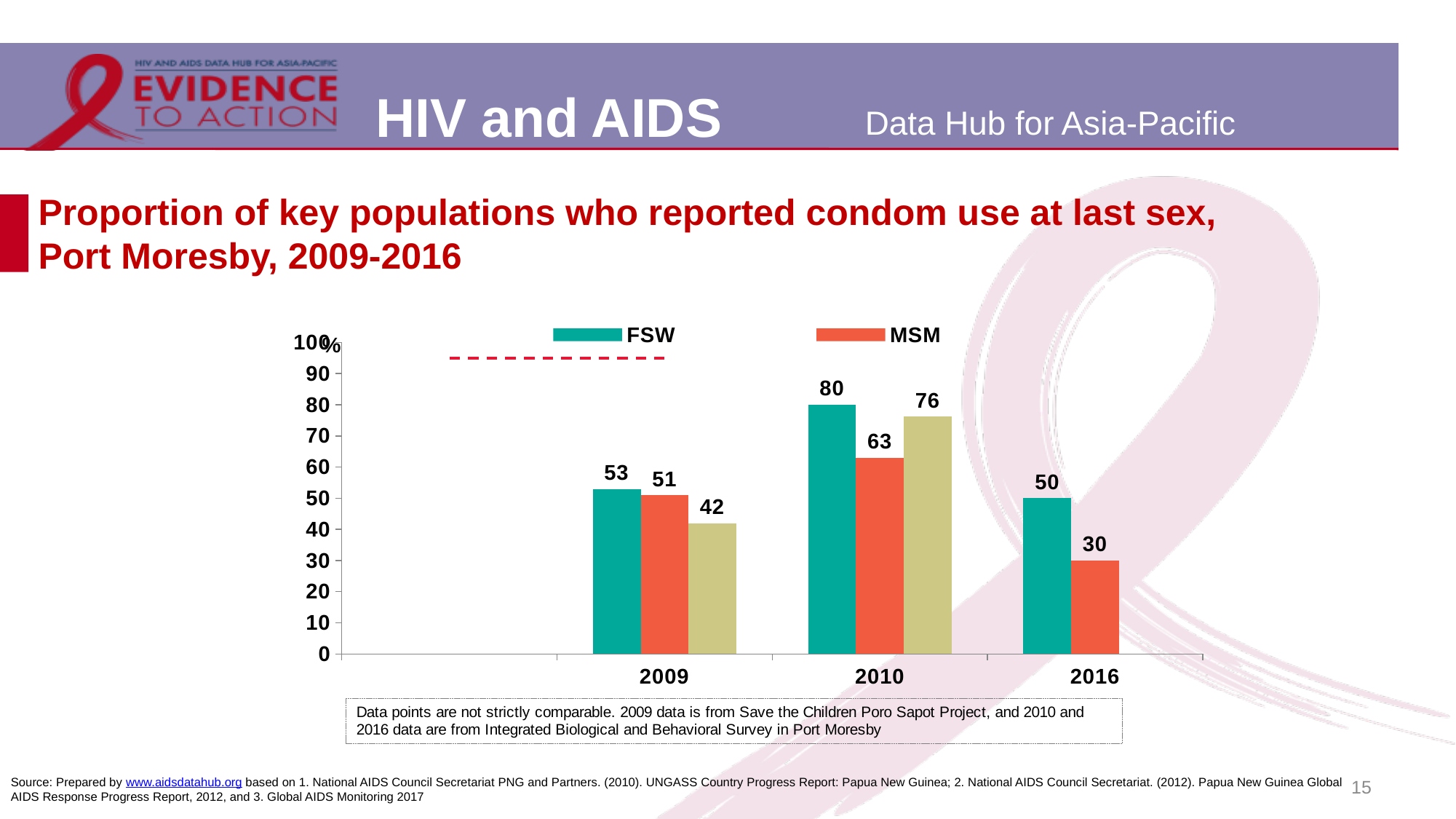
What is the value for FSW in 2010? 80 In which year is the FSW value highest? 2010 What is the value for FSW in 2016? 50 What is the value for MSM in 2016? 30 What is the value for MSM in 2009? 51 Which colour represents MSM in the chart? Orange In which year is the MSM value lowest? 2016 What kind of chart is shown on the slide? Bar chart How many years are shown on the x axis? 3 What is the difference between the FSW and MSM values in 2010? 17 Which is larger in 2016, the FSW value or the MSM value? FSW What is the difference between the FSW values in 2010 and 2016? 30